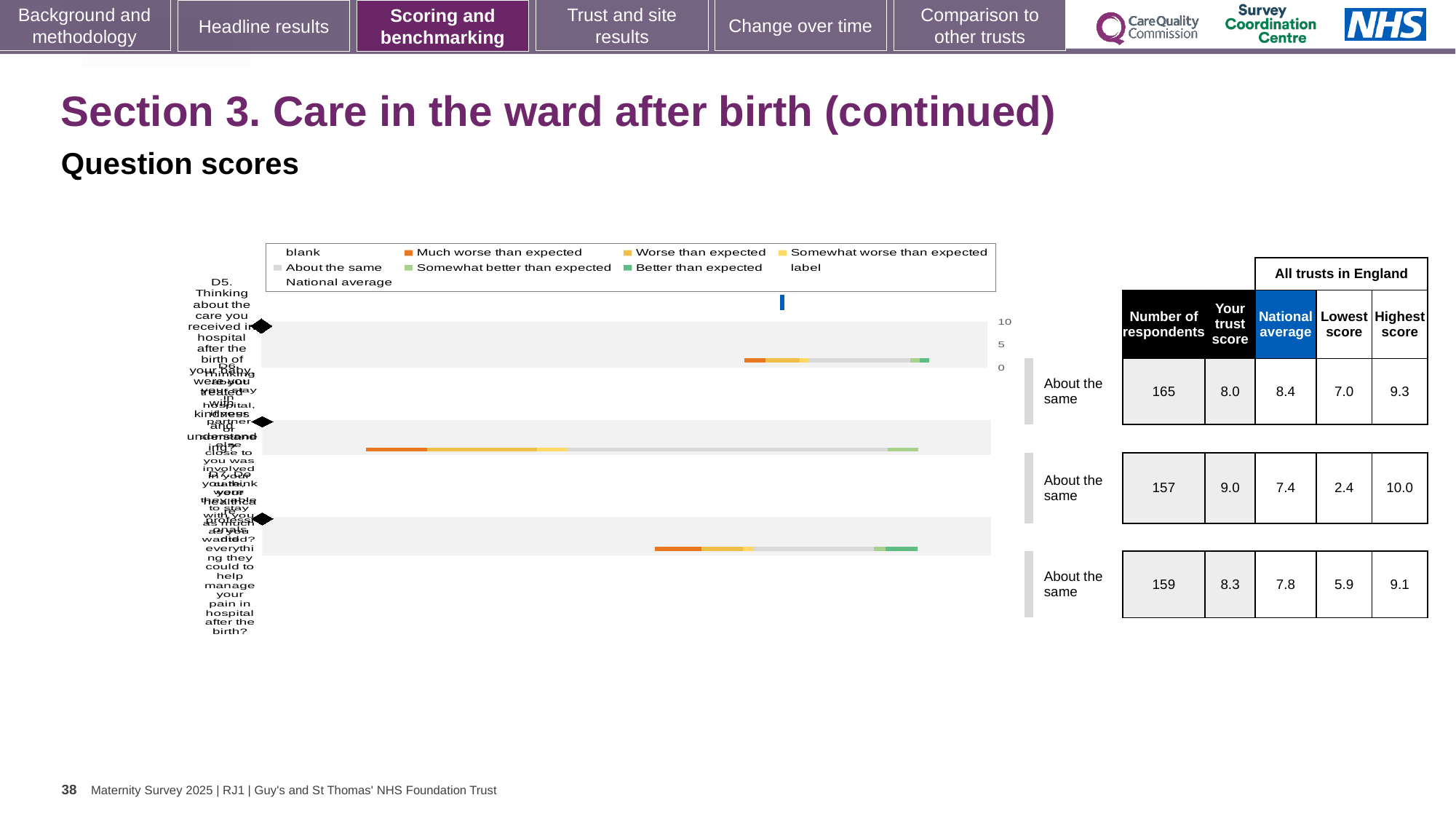
What kind of chart is shown on the slide? bar chart How many bars are plotted in the chart? 3 What colour does the legend use for 'Better than expected'? green What is the highest tick value shown on the chart's axis? 10 What colour does the legend use for 'Much worse than expected'? orange